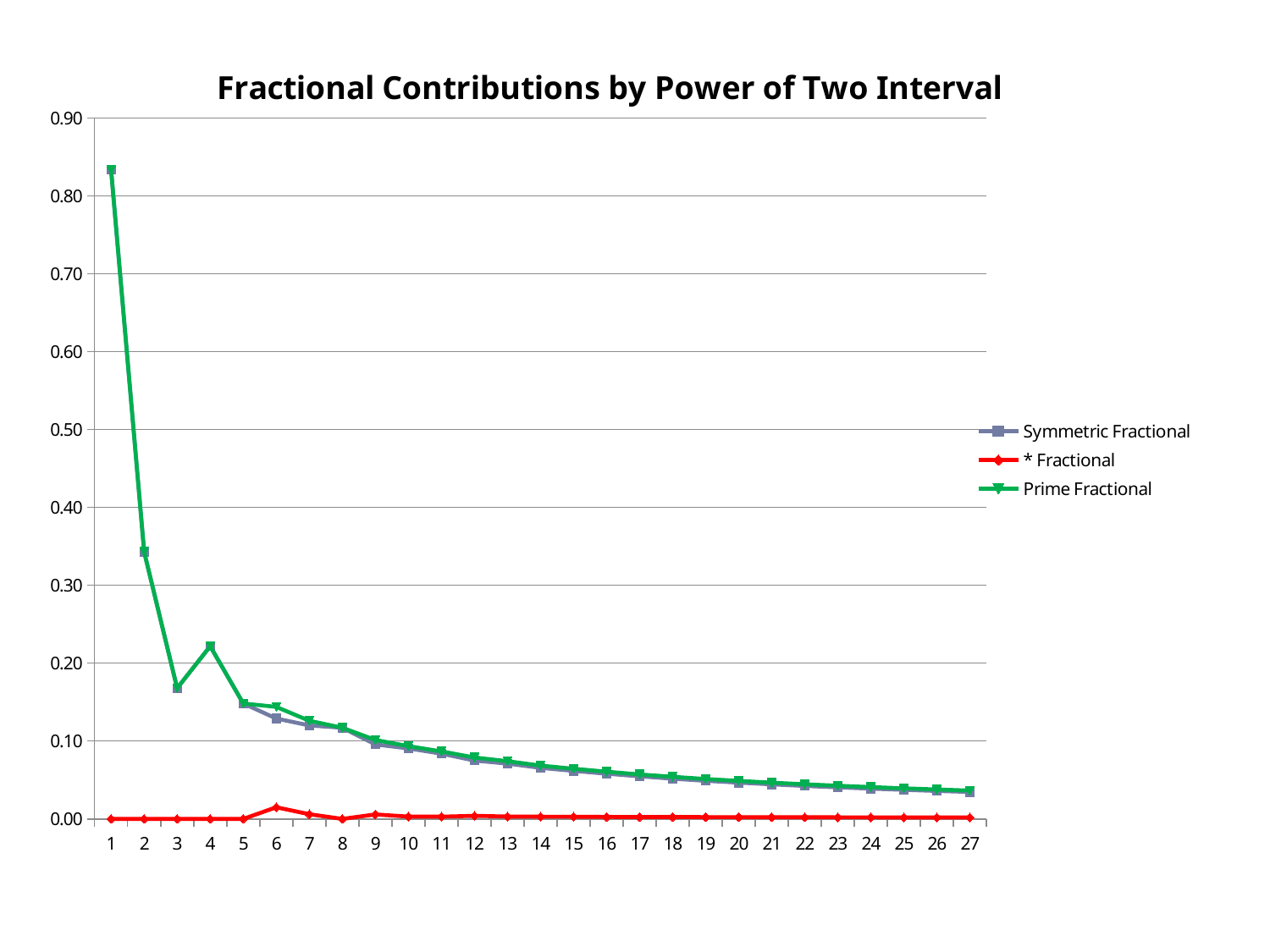
Which colour is used for the * Fractional series? Red What is the title of the chart? Fractional Contributions by Power of Two Interval What kind of chart is shown on the slide? Line chart At which interval is the Prime Fractional value highest? 1 Is the Prime Fractional value at interval 3 greater or less than 0.20? less How many series does the legend list? 3 Which series has the lowest values across the chart? * Fractional Is the Prime Fractional value at interval 1 greater or less than 0.80? greater Is the Symmetric Fractional value at interval 27 greater or less than 0.10? less Do the Prime Fractional values generally rise or fall as the interval increases from 1 to 27? Fall How many intervals are plotted along the x axis? 27 Which is larger for Prime Fractional: the value at interval 3 or at interval 4? Interval 4